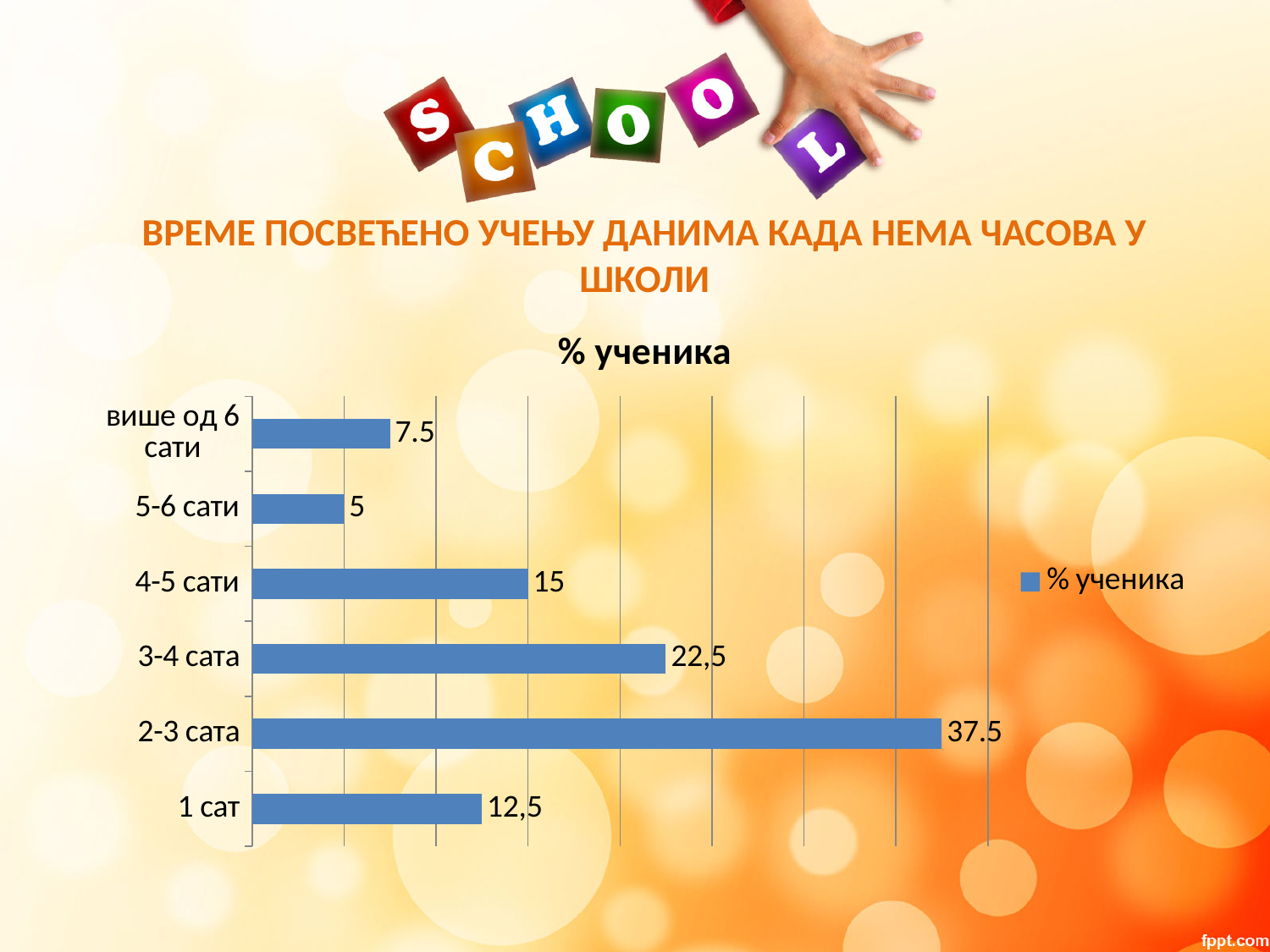
What kind of chart is shown on the slide? Bar chart What is the value for the category "2-3 сата"? 37.5 What is the value for the category "3-4 сата"? 22,5 What is the difference between the values for "2-3 сата" and "3-4 сата"? 15 What is the difference between the values for "4-5 сати" and "5-6 сати"? 10 What is the value for the category "1 сат"? 12,5 Which category has the lowest value? 5-6 сати How many categories are shown in the chart? 6 Which category has the highest value? 2-3 сата What is the value for the category "више од 6 сати"? 7.5 What is the title of the chart? % ученика Which is larger, the value for "1 сат" or the value for "4-5 сати"? 4-5 сати